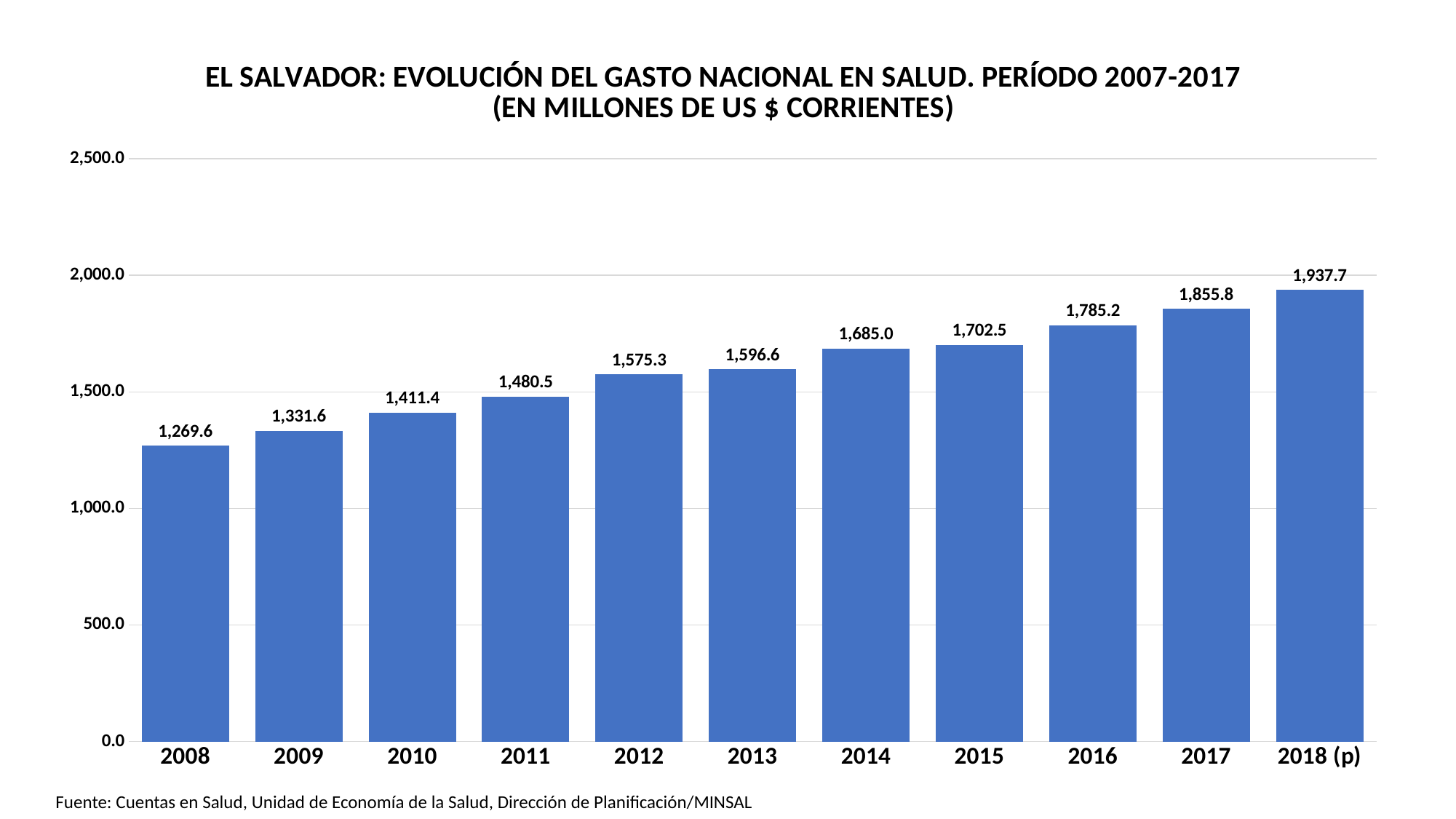
What is the difference between the values for 2017 and 2016? 70.6 What is the value for 2008? 1,269.6 What is the value for 2012? 1,575.3 What is the difference between the values for 2018 (p) and 2008? 668.1 Which year has the highest value? 2018 (p) How many years are shown on the x axis? 11 Which year has the lowest value? 2008 What is the value for 2018 (p)? 1,937.7 Is the value for 2010 greater or less than 1,500.0? less Do the values rise or fall from 2008 to 2018 (p)? rise What kind of chart is this? bar chart Which is larger, the value for 2014 or the value for 2011? 2014